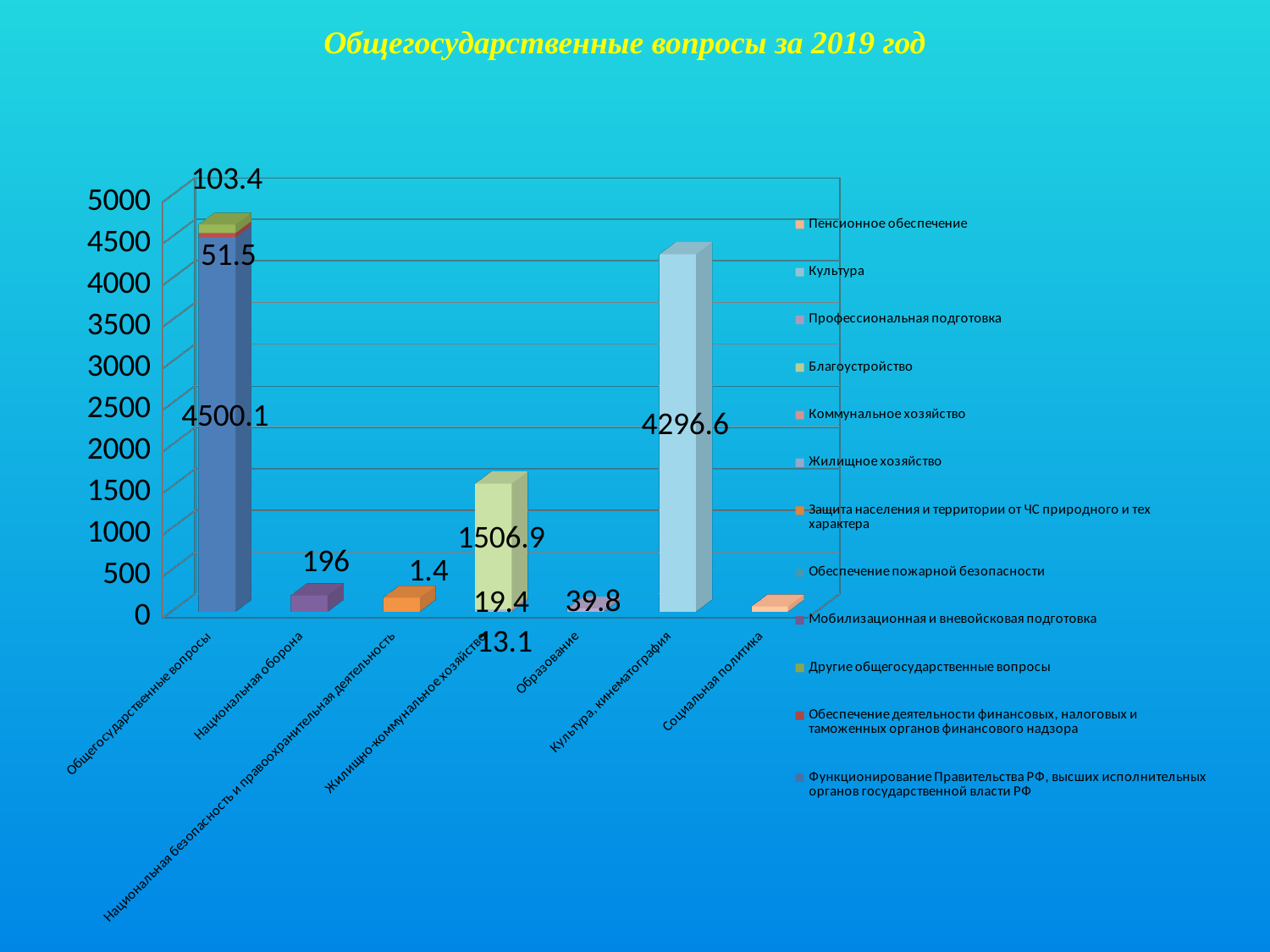
Which bar is taller: Культура, кинематография or Жилищно-коммунальное хозяйство? Культура, кинематография How many categories are shown on the x axis? 7 What is the total of the stacked Общегосударственные вопросы bar (4500.1, 51.5 and 103.4)? 4655.0 What is the value labelled for the Культура, кинематография bar? 4296.6 What is the title of the chart? Общегосударственные вопросы за 2019 год What is the value labelled for the Национальная оборона bar? 196 What is the value labelled for the Образование bar? 39.8 Is the value for Национальная оборона greater or less than 500? less How many series does the legend list? 12 What is the difference between the largest segment of the Общегосударственные вопросы bar (4500.1) and the Культура, кинематография bar (4296.6)? 203.5 What is the largest segment value labelled in the Жилищно-коммунальное хозяйство bar? 1506.9 What kind of chart is shown on the slide? Bar chart